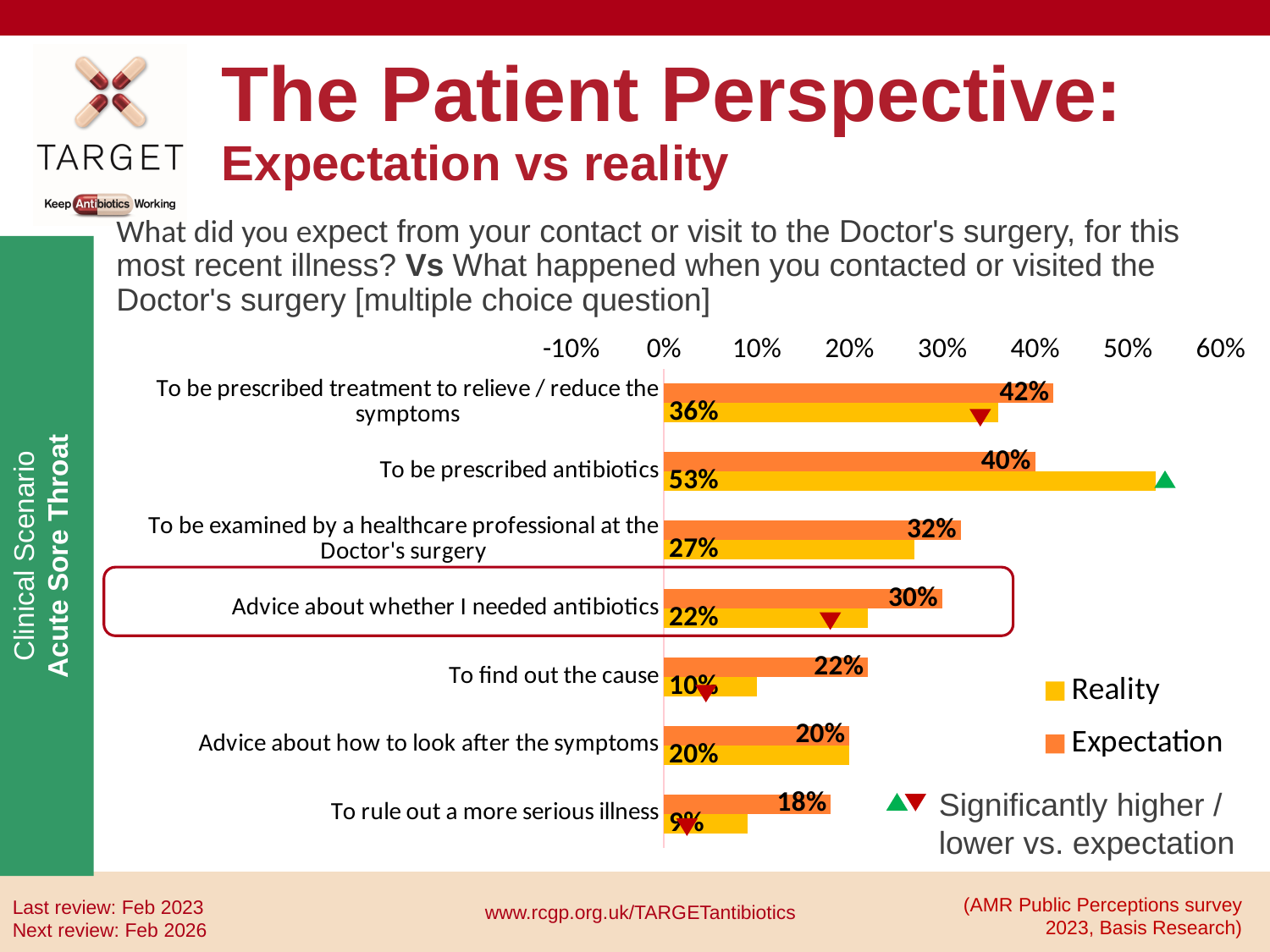
What is the Expectation value for "To be prescribed antibiotics"? 40% How many series does the legend list? 2 What kind of chart is shown on the slide? Bar chart What is the Reality value for "To find out the cause"? 10% Which colour represents the Reality series in the chart? Yellow How many categories are shown in the chart? 7 What is the difference between the Reality and Expectation values for "To be prescribed antibiotics"? 13% Which category has the lowest Reality value? To rule out a more serious illness What is the Expectation value for "Advice about whether I needed antibiotics"? 30% Which category has the highest Expectation value? To be prescribed treatment to relieve / reduce the symptoms What is the Reality value for "To be prescribed antibiotics"? 53% For "To find out the cause", which is larger: the Expectation value or the Reality value? Expectation